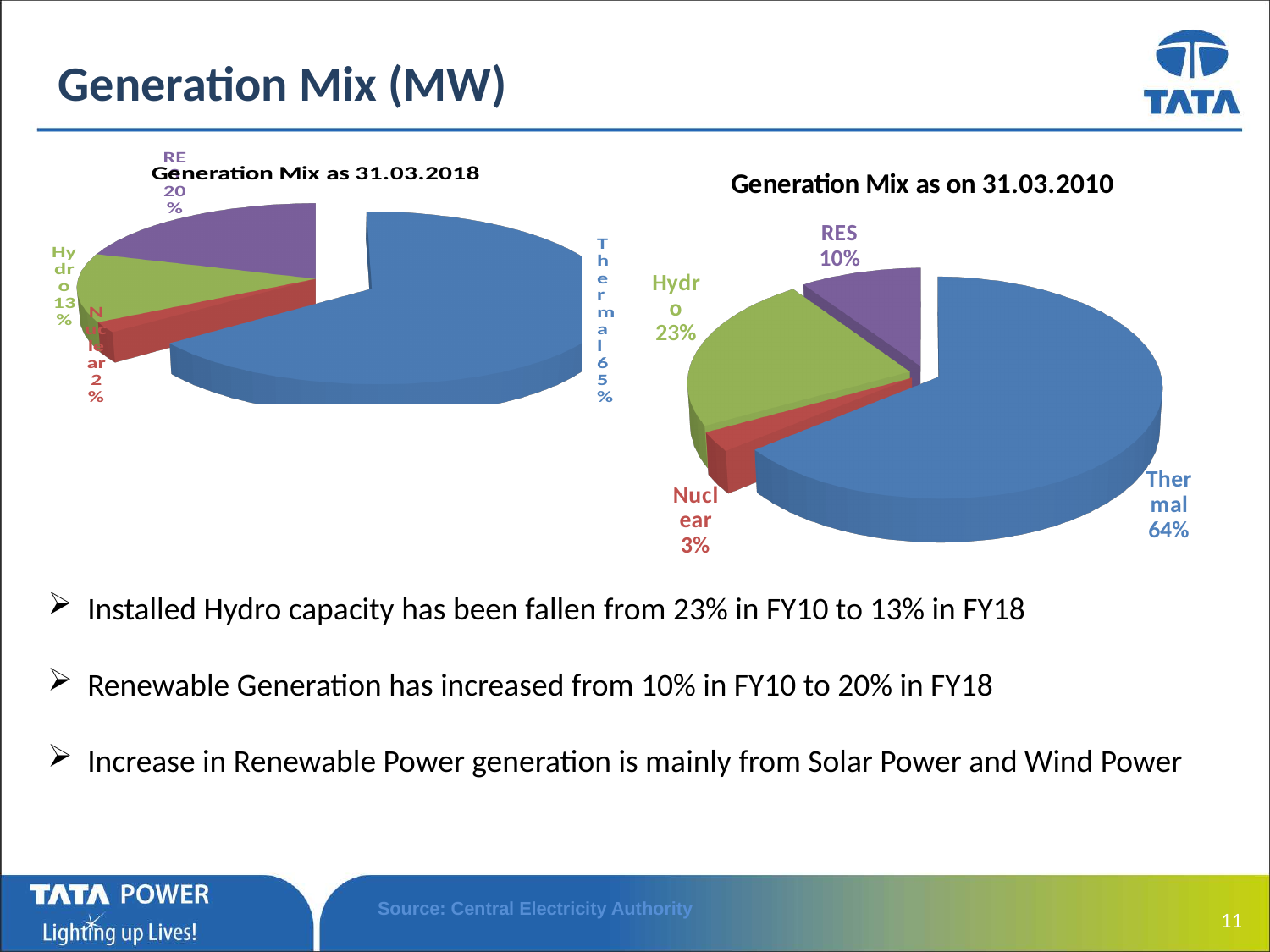
In the Generation Mix as on 31.03.2010 chart, which category has the largest share? Thermal In the Generation Mix as 31.03.2018 chart, what share does Hydro have? 13% In the Generation Mix as on 31.03.2010 chart, what share does Hydro have? 23% What type of chart is used for the Generation Mix as on 31.03.2010? Pie chart In the Generation Mix as on 31.03.2010 chart, what share does RES have? 10% In the Generation Mix as on 31.03.2010 chart, what share does Nuclear have? 3% In the Generation Mix as 31.03.2018 chart, what share does Thermal have? 65% In the Generation Mix as on 31.03.2010 chart, what is the difference between the Hydro share and the RES share? 13% In the Generation Mix as 31.03.2018 chart, what share does RE have? 20% In the Generation Mix as 31.03.2018 chart, which category has the smallest share? Nuclear In the Generation Mix as on 31.03.2010 chart, what share does Thermal have? 64% How many slices does the Generation Mix as on 31.03.2010 pie chart have? 4